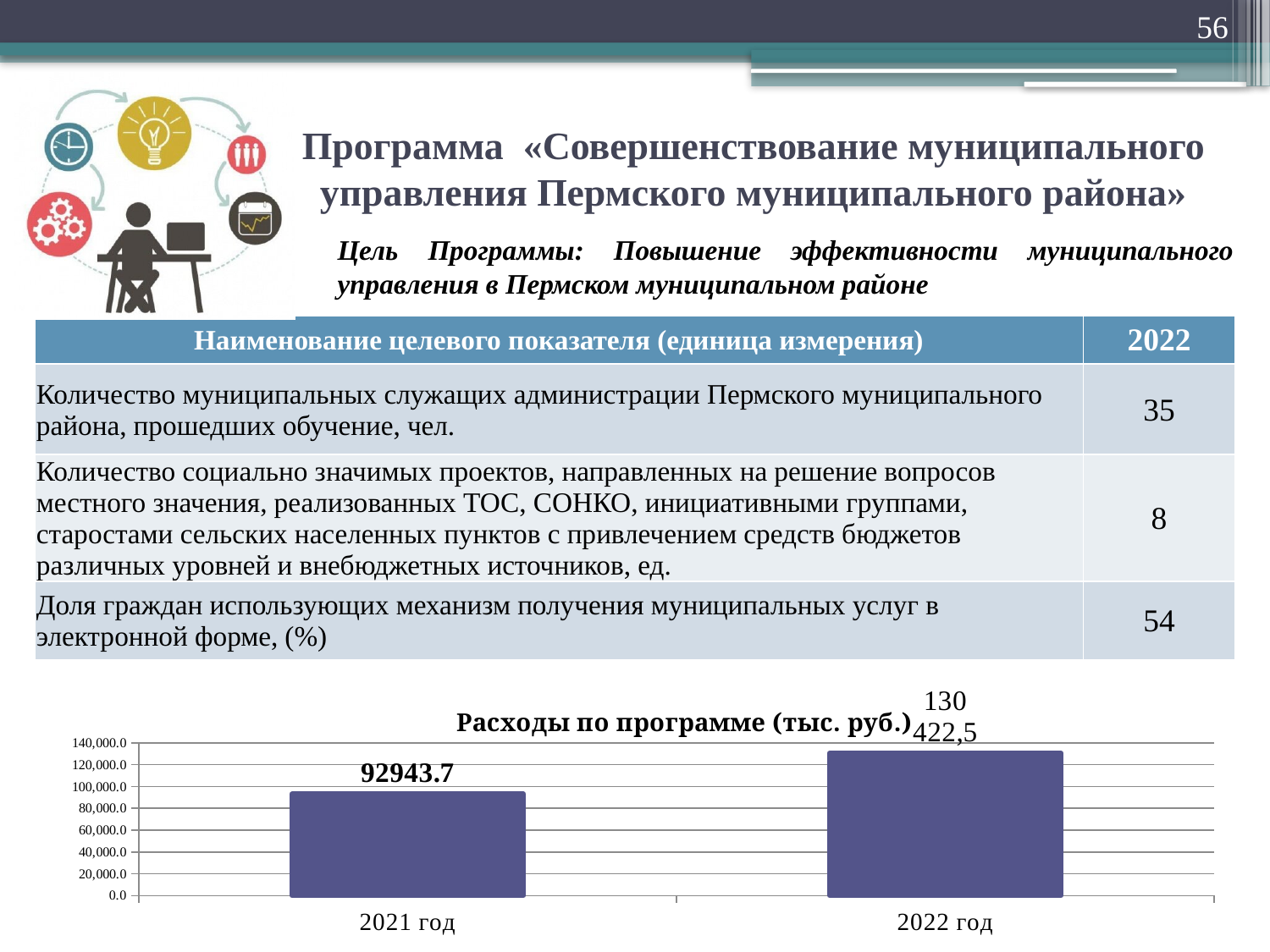
In the chart 'Расходы по программе (тыс. руб.)', is the value for 2022 год greater or less than 120,000.0? greater What is the highest tick value shown on the y axis of the chart 'Расходы по программе (тыс. руб.)'? 140,000.0 Which year has the lowest value in the chart 'Расходы по программе (тыс. руб.)'? 2021 год What is the title of the chart at the bottom of the slide? Расходы по программе (тыс. руб.) Which year has the highest value in the chart 'Расходы по программе (тыс. руб.)'? 2022 год What is the value for 2021 год in the chart 'Расходы по программе (тыс. руб.)'? 92943.7 How many categories are shown on the x axis of the chart 'Расходы по программе (тыс. руб.)'? 2 In the chart 'Расходы по программе (тыс. руб.)', which is larger: the value for 2021 год or for 2022 год? 2022 год Do the values in the chart 'Расходы по программе (тыс. руб.)' rise or fall from 2021 год to 2022 год? rise In the chart 'Расходы по программе (тыс. руб.)', is the value for 2021 год greater or less than 100,000.0? less What kind of chart is 'Расходы по программе (тыс. руб.)'? bar chart In the chart 'Расходы по программе (тыс. руб.)', is the value for 2021 год greater or less than 80,000.0? greater